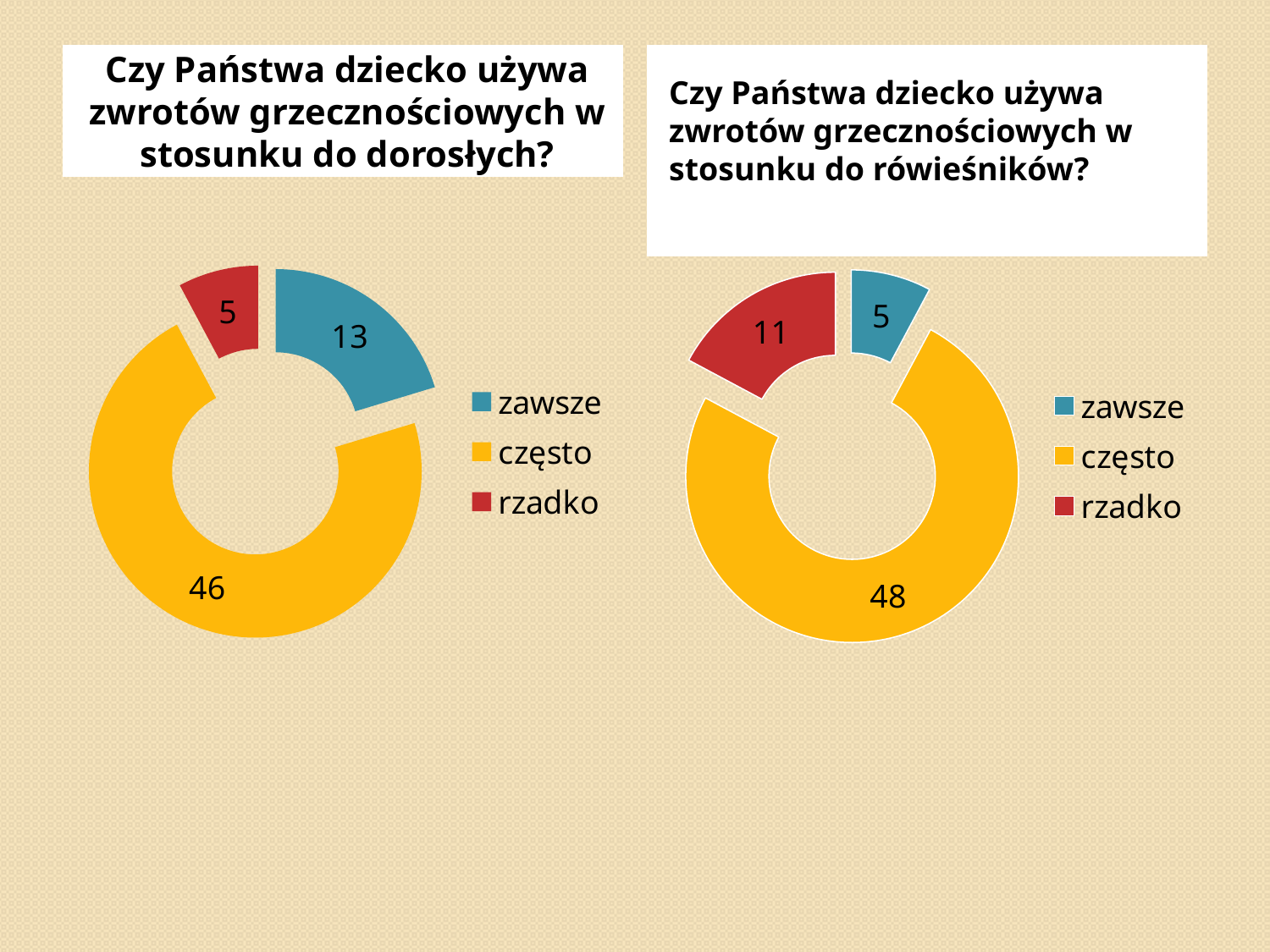
In the right chart (stosunku do rówieśników), which category has the smallest value? zawsze What kind of chart is the left chart (stosunku do dorosłych)? doughnut chart In the left chart (stosunku do dorosłych), which category has the largest value? często In the left chart (stosunku do dorosłych), what is the value for "zawsze"? 13 In the right chart (stosunku do rówieśników), what is the value for "rzadko"? 11 How many categories does the right chart (stosunku do rówieśników) show? 3 Which is larger: the value for "zawsze" in the left chart or the value for "zawsze" in the right chart? the left chart (13) In the right chart (stosunku do rówieśników), what is the value for "zawsze"? 5 In the left chart (stosunku do dorosłych), what is the difference between the values for "zawsze" and "rzadko"? 8 In the left chart (stosunku do dorosłych), what is the value for "często"? 46 In the right chart (stosunku do rówieśników), what is the difference between the values for "często" and "rzadko"? 37 In the right chart (stosunku do rówieśników), what share of the total does "często" represent? 75%